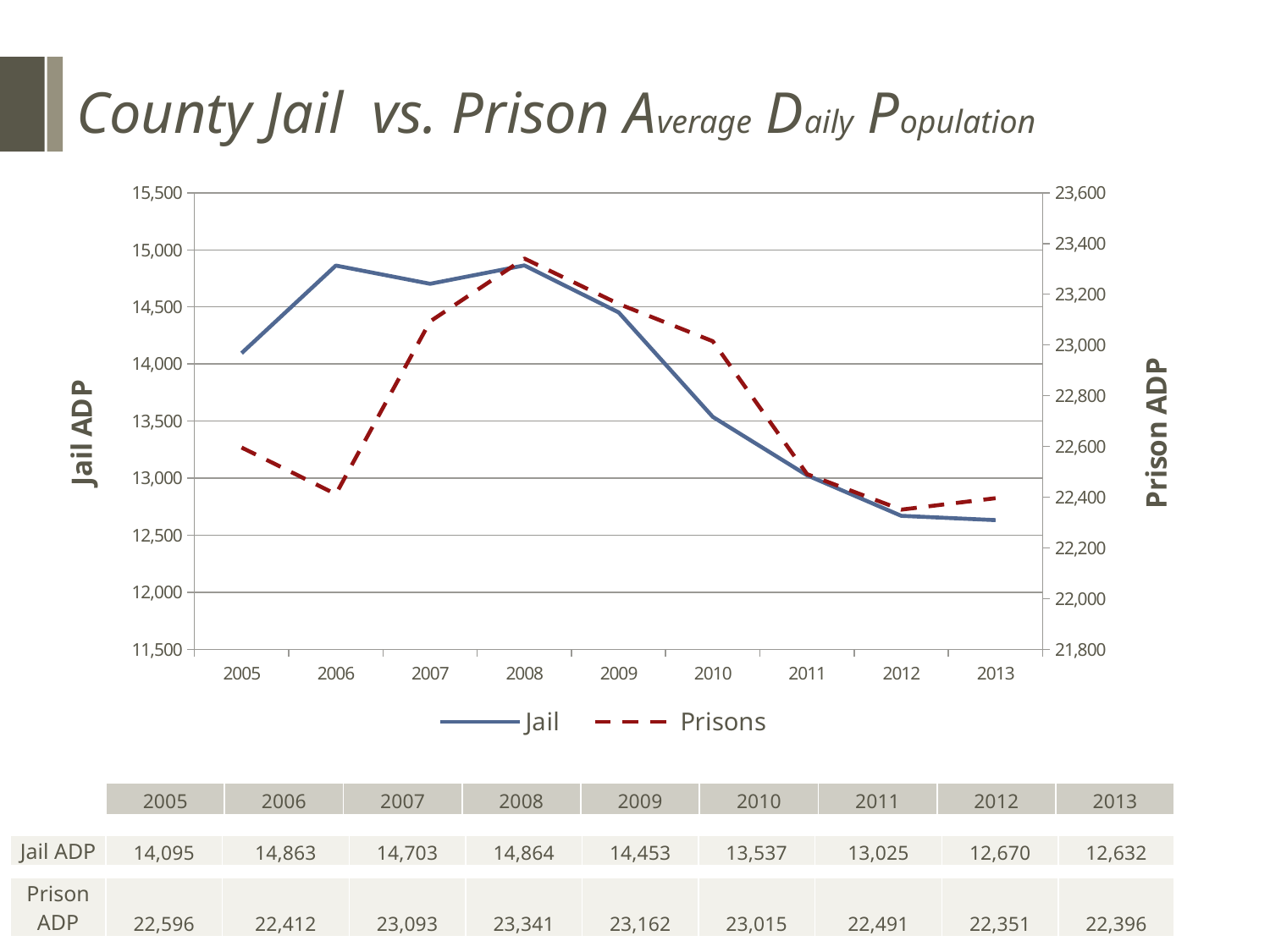
What is the difference between the Prison ADP in 2008 and in 2007? 248 Which is larger, the Jail ADP in 2006 or in 2010? 2006 What is the Jail ADP value for 2005? 14,095 Is the Jail ADP value for 2010 greater or less than 14,000? less What is the difference between the Jail ADP in 2005 and in 2013? 1,463 Does the Jail ADP rise or fall from 2009 to 2013? fall What is the Prison ADP value for 2008? 23,341 How many series does the legend list? 2 What kind of chart is shown on the slide? line chart In which year is the Prison ADP highest? 2008 What is the Jail ADP value for 2013? 12,632 How many years are plotted on the x axis? 9